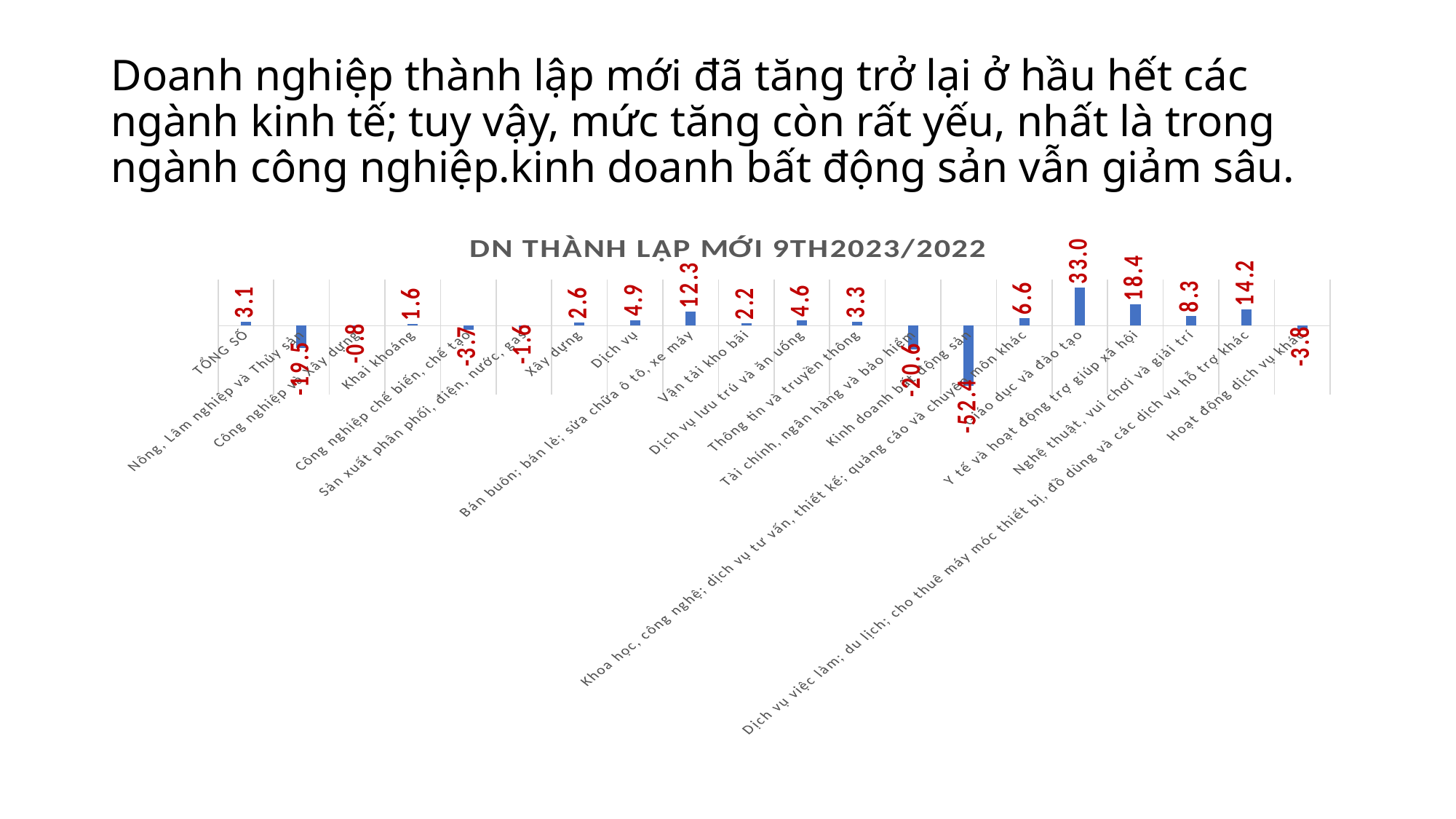
What is the title of the chart? DN THÀNH LẬP MỚI 9TH2023/2022 Which category has the highest value? Giáo dục và đào tạo What is the value for Kinh doanh bất động sản? -52.4 What is the value for Y tế và hoạt động trợ giúp xã hội? 18.4 What is the difference between the values for Giáo dục và đào tạo and Y tế và hoạt động trợ giúp xã hội? 14.6 Which category has the lowest value? Kinh doanh bất động sản Which is larger, the value for Bán buôn; bán lẻ; sửa chữa ô tô, xe máy or the value for Nghệ thuật, vui chơi và giải trí? Bán buôn; bán lẻ; sửa chữa ô tô, xe máy What is the value for TỔNG SỐ? 3.1 How many categories are shown in the chart? 20 What is the value for Nông, Lâm nghiệp và Thủy sản? -19.5 What is the value for Giáo dục và đào tạo? 33.0 What type of chart is shown on the slide? Bar chart